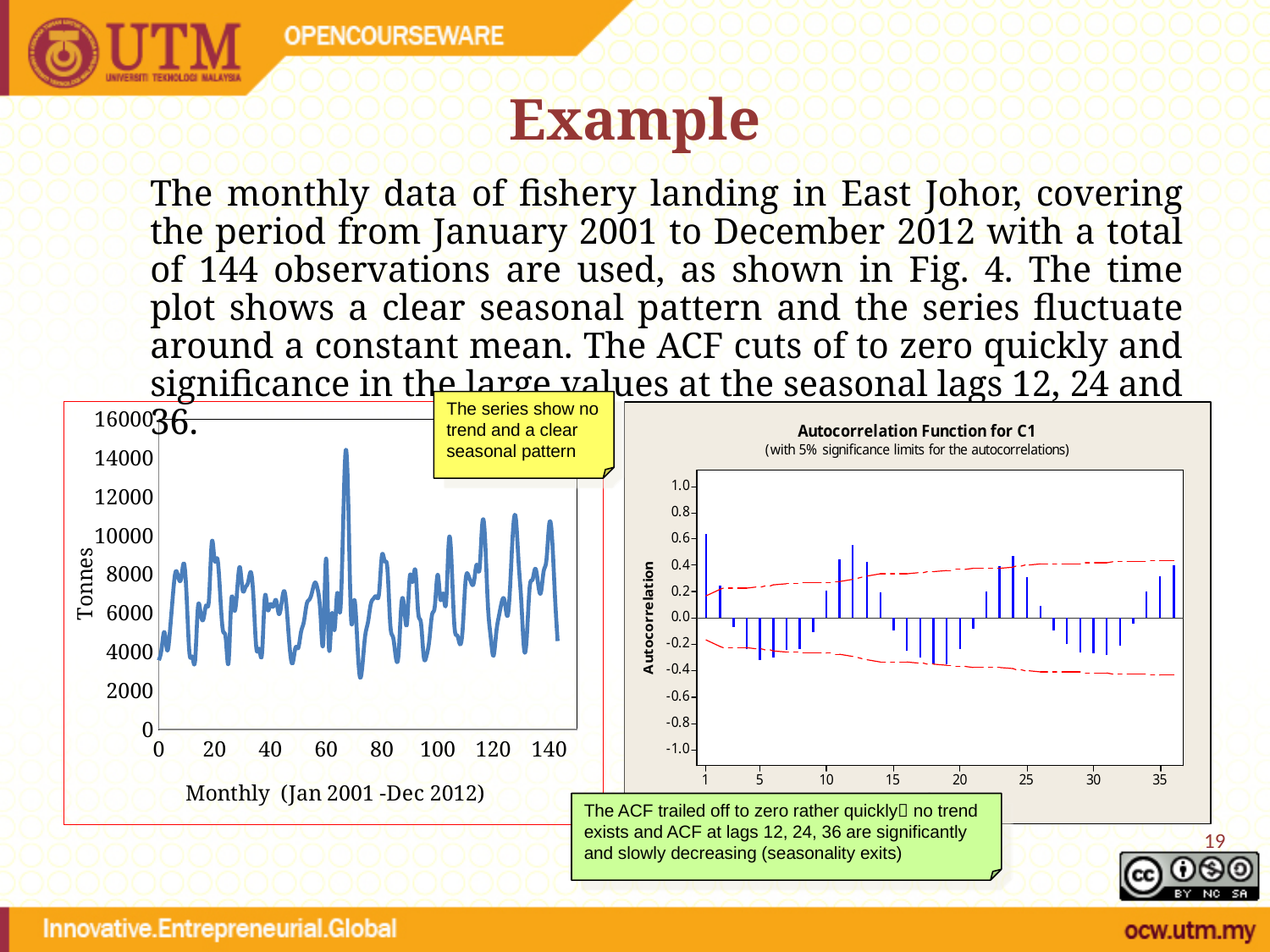
In the left chart, is the value at observation 0 greater or less than 6000 tonnes? less In the right chart (Autocorrelation Function for C1), which lag has the highest autocorrelation, lag 1 or lag 6? lag 1 In the right chart (Autocorrelation Function for C1), is the autocorrelation at lag 18 greater or less than -0.2? less What is the y-axis label of the left chart? Tonnes In the right chart (Autocorrelation Function for C1), is the autocorrelation at lag 24 greater or less than 0.2? greater What is the title of the right chart? Autocorrelation Function for C1 What kind of chart is the left chart showing fishery landing in tonnes? line chart What is the maximum value shown on the y-axis of the left chart? 16000